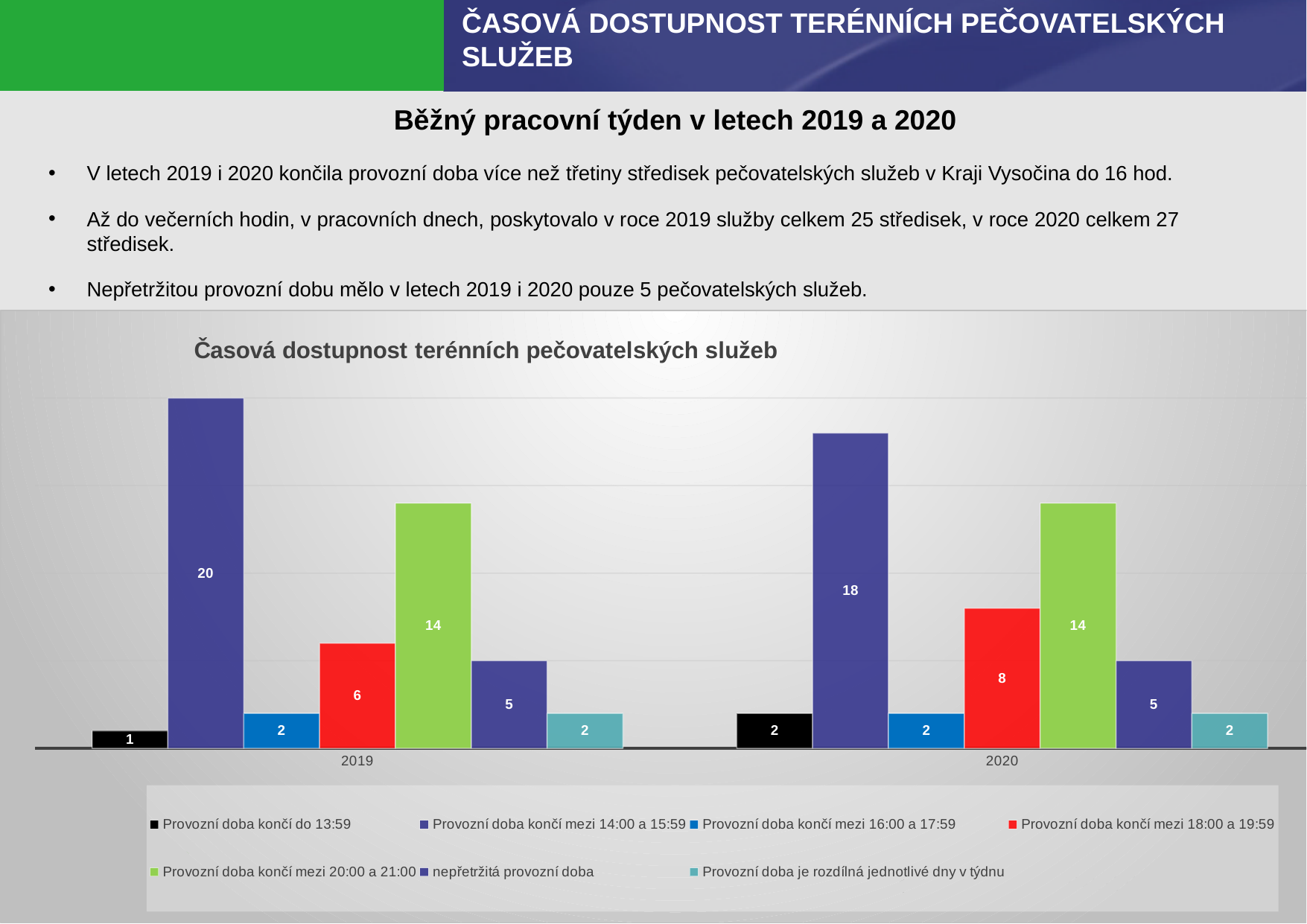
How many year categories are shown on the x axis of the chart? 2 What is the value for 'Provozní doba končí mezi 18:00 a 19:59' in 2020? 8 What is the value for 'Provozní doba končí do 13:59' in 2019? 1 Which series has the lowest value in 2019? Provozní doba končí do 13:59 What is the title of the chart? Časová dostupnost terénních pečovatelských služeb What is the value for 'Provozní doba končí mezi 14:00 a 15:59' in 2020? 18 How many series does the chart legend list? 7 What type of chart is shown on the slide? bar chart Which is larger: the 2019 value or the 2020 value for 'Provozní doba končí mezi 14:00 a 15:59'? 2019 Which series has the highest value in 2019? Provozní doba končí mezi 14:00 a 15:59 What is the difference between the 2019 and 2020 values for 'Provozní doba končí mezi 18:00 a 19:59'? 2 What is the value for 'Provozní doba končí mezi 14:00 a 15:59' in 2019? 20